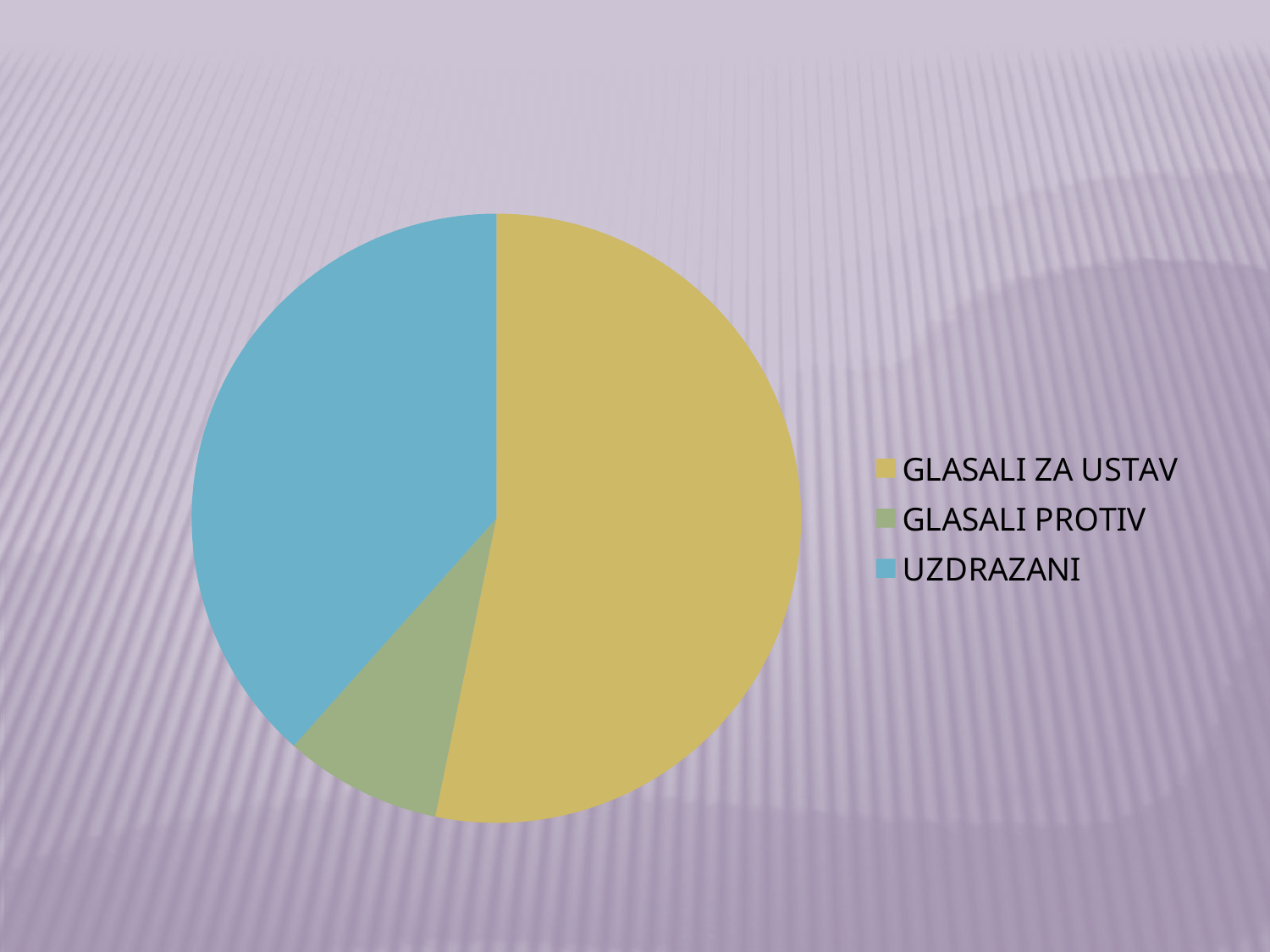
How many entries does the legend of the pie chart list? 3 What kind of chart is shown on the slide? Pie chart Which category has the largest slice of the pie chart? GLASALI ZA USTAV Which category is shown in green in the pie chart? GLASALI PROTIV What colour is the UZDRAZANI slice in the pie chart? Blue How many slices does the pie chart have? 3 Which slice is larger, UZDRAZANI or GLASALI PROTIV? UZDRAZANI Which category has the smallest slice of the pie chart? GLASALI PROTIV Which slice is smaller, GLASALI PROTIV or GLASALI ZA USTAV? GLASALI PROTIV Which slice is larger, GLASALI ZA USTAV or UZDRAZANI? GLASALI ZA USTAV